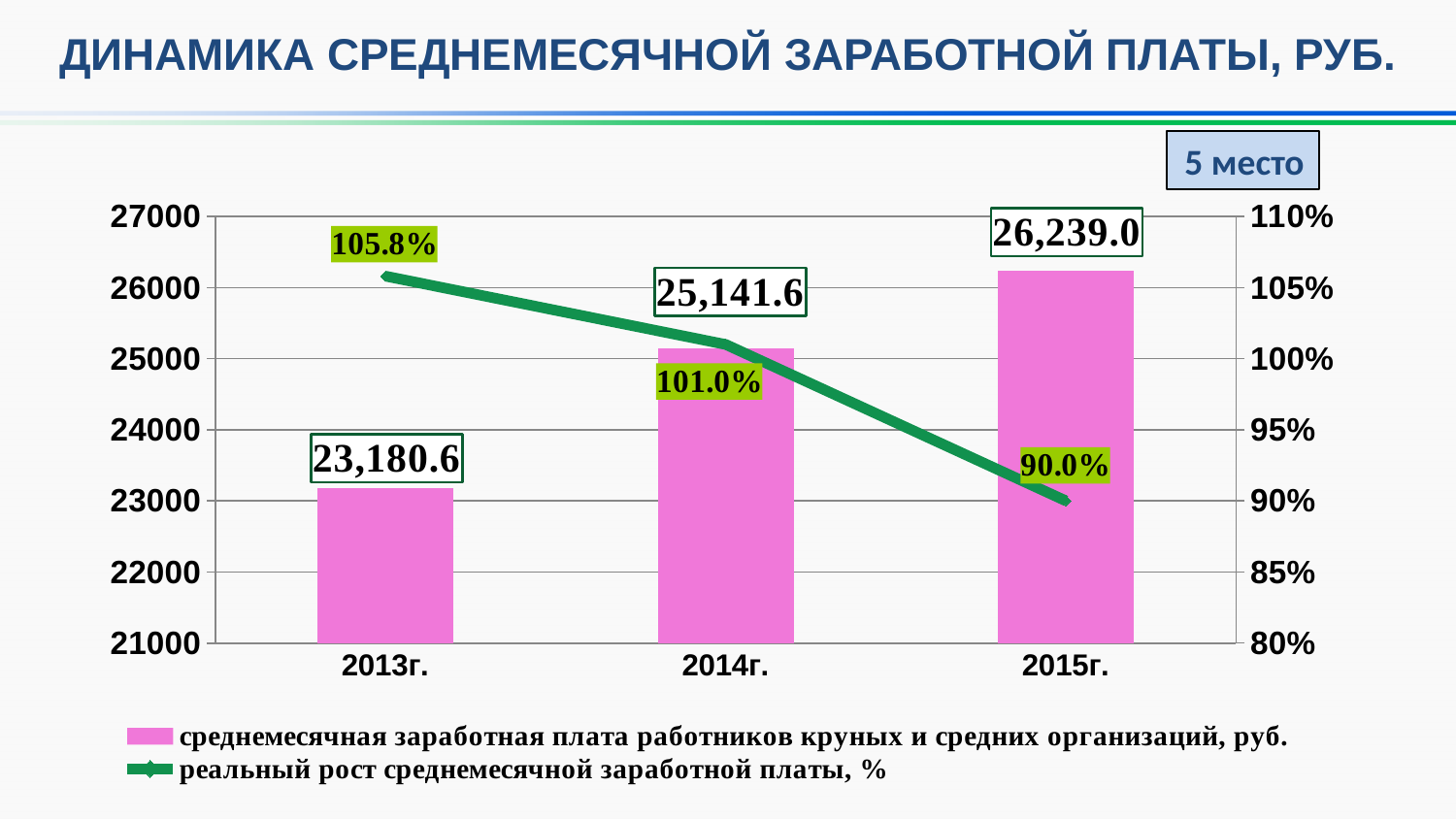
Which year has the highest average monthly salary bar? 2015г. How many years are shown on the x axis? 3 What is the real growth of average monthly salary (%) shown for 2013г.? 105.8% What colour are the bars for average monthly salary? pink Is the average monthly salary bar for 2013г. greater or less than 24000? less What is the average monthly salary value shown for 2014г.? 25,141.6 Which is larger: the real growth percentage for 2014г. or for 2015г.? 2014г. Does the real growth of average monthly salary line rise or fall from 2013г. to 2015г.? fall How many series does the legend list? 2 What is the average monthly salary value shown for 2015г.? 26,239.0 Which year has the lowest real growth of average monthly salary (%)? 2015г. What is the difference between the average monthly salary in 2015г. and 2013г.? 3,058.4